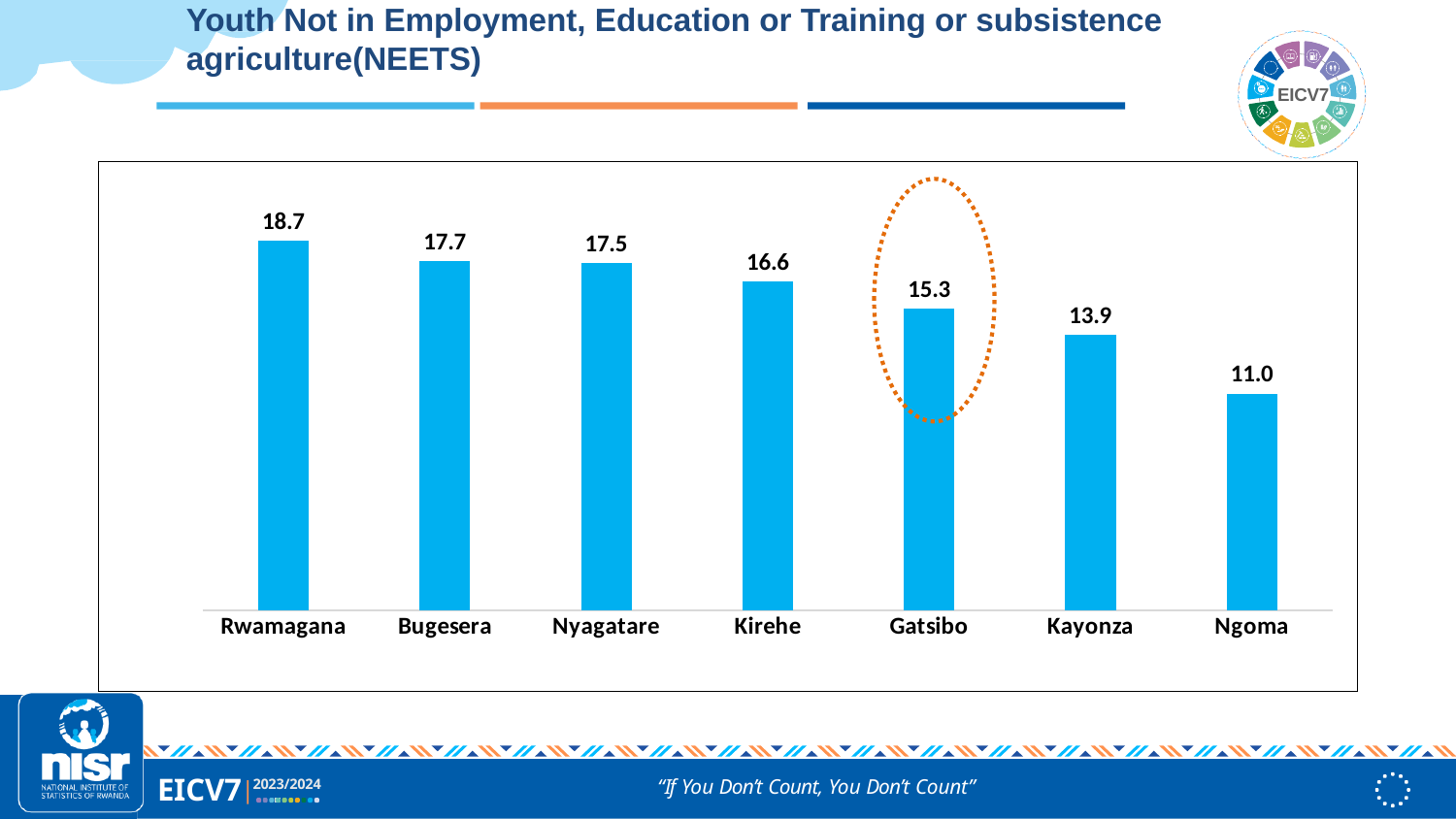
What kind of chart is shown on the slide? Bar chart What is the difference between the values for Rwamagana and Ngoma? 7.7 Which district has the highest value? Rwamagana What is the value for Gatsibo? 15.3 What is the value for Ngoma? 11.0 Which district has the lowest value? Ngoma What is the value for Rwamagana? 18.7 How many districts are shown in the chart? 7 What is the difference between the values for Bugesera and Kayonza? 3.8 Which is larger, the value for Nyagatare or the value for Kayonza? Nyagatare What is the value for Kirehe? 16.6 Do the values rise or fall from left to right across the districts? Fall